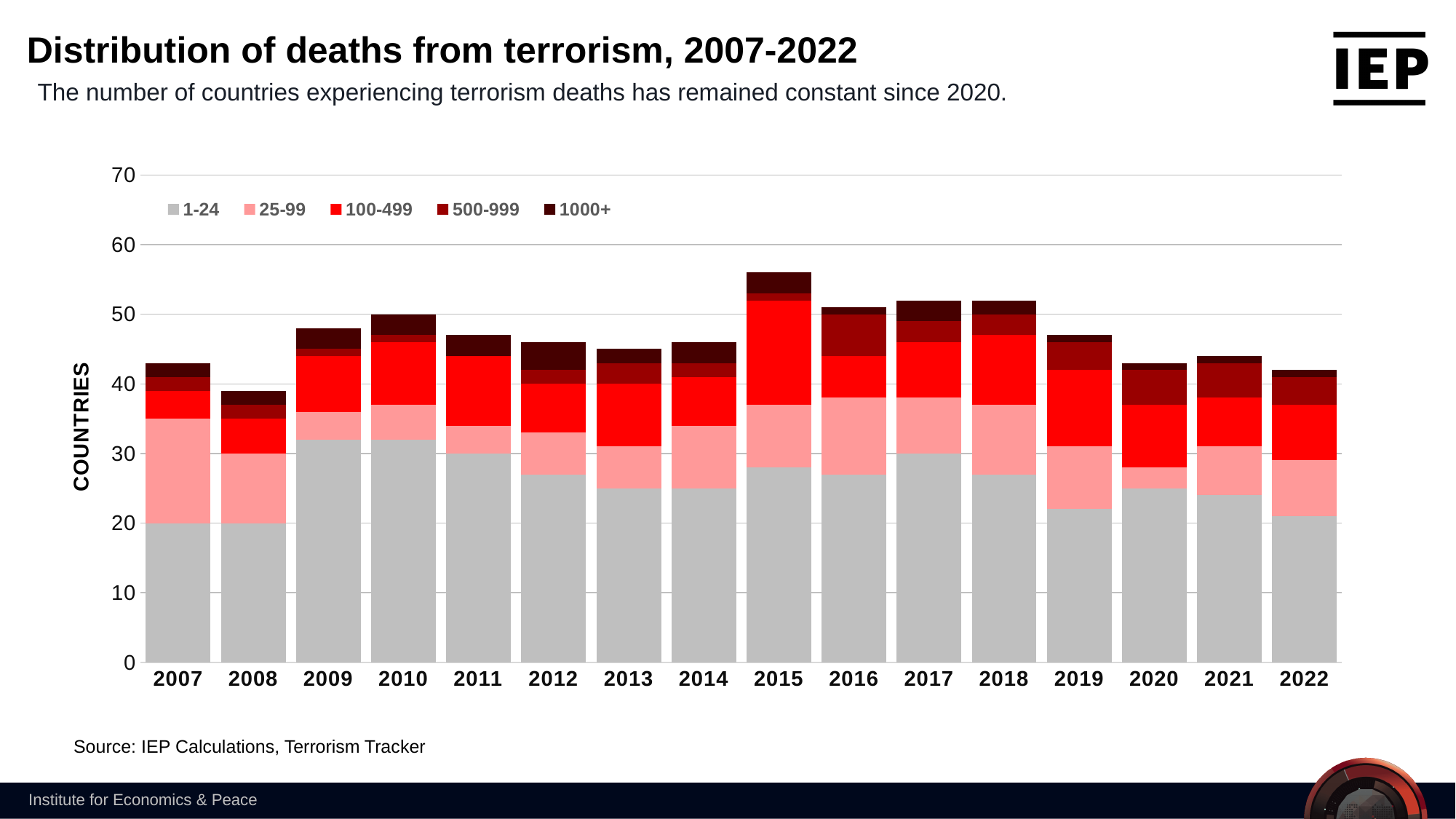
Which year has the highest total number of countries? 2015 How many series does the legend list? 5 Do the total bar heights rise or fall from 2018 to 2022? fall Is the total number of countries in 2015 greater or less than 50? greater How many years are shown along the x axis? 16 What are the legend entries of the chart? 1-24, 25-99, 100-499, 500-999, 1000+ Which year has the lowest total number of countries? 2008 What is the title of the y axis? COUNTRIES What kind of chart is shown on the slide? Stacked bar chart Is the total number of countries in 2022 greater or less than 40? greater Which year has a larger total number of countries, 2009 or 2008? 2009 Is the total number of countries in 2008 greater or less than 40? less